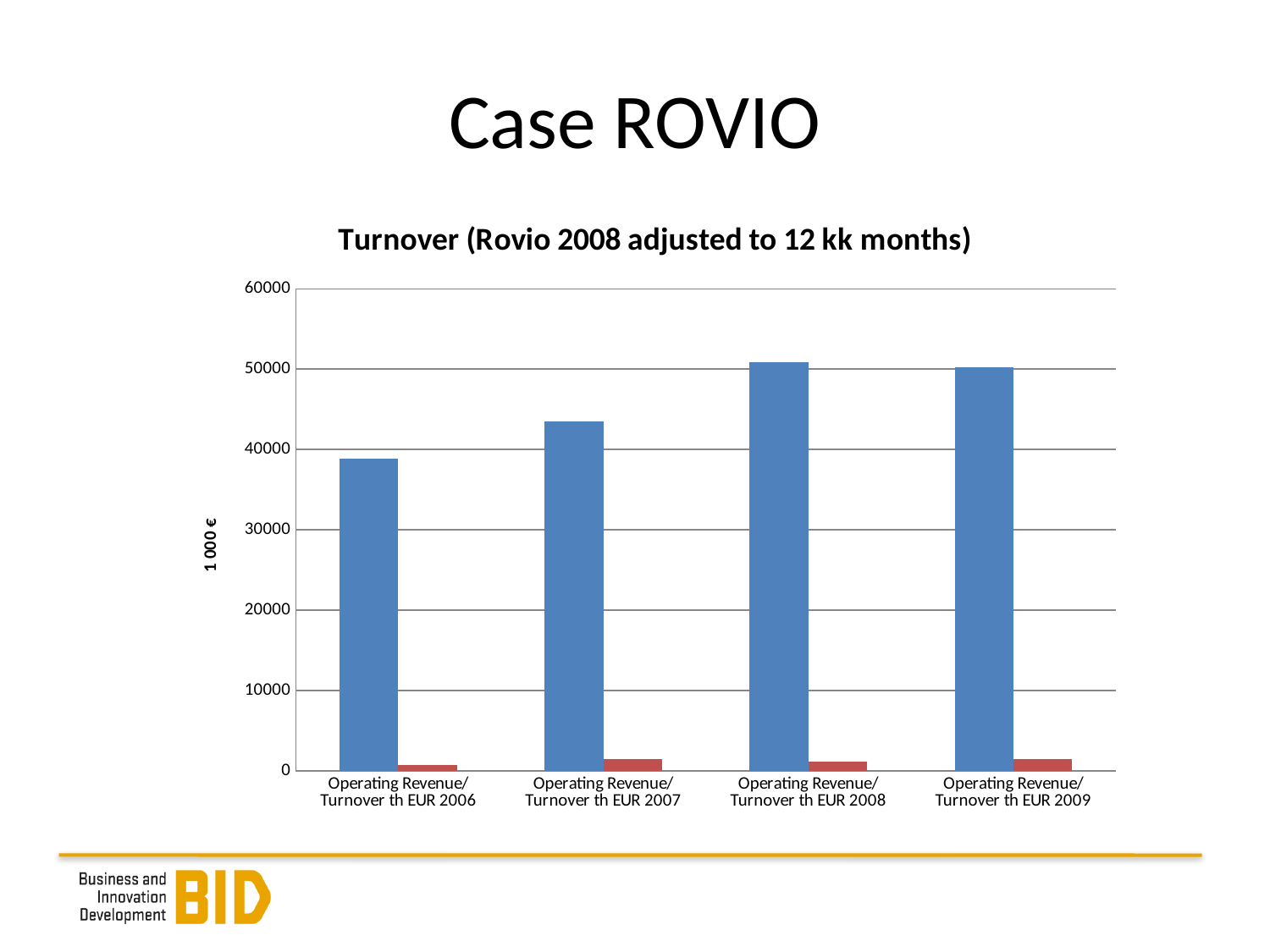
Do the blue bars rise or fall from 2006 to 2008? rise Which blue bar is taller, Operating Revenue/Turnover th EUR 2006 or Operating Revenue/Turnover th EUR 2007? Operating Revenue/Turnover th EUR 2007 Which category has the lowest blue bar? Operating Revenue/Turnover th EUR 2006 Is the blue bar for Operating Revenue/Turnover th EUR 2007 greater or less than 40000? greater Is the blue bar for Operating Revenue/Turnover th EUR 2006 greater or less than 40000? less Is the red bar for Operating Revenue/Turnover th EUR 2007 greater or less than 10000? less What is the label on the vertical axis of the chart? 1 000 € How many categories are shown along the x axis of the chart? 4 What kind of chart is shown on the slide? bar chart What is the title of the chart? Turnover (Rovio 2008 adjusted to 12 kk months)